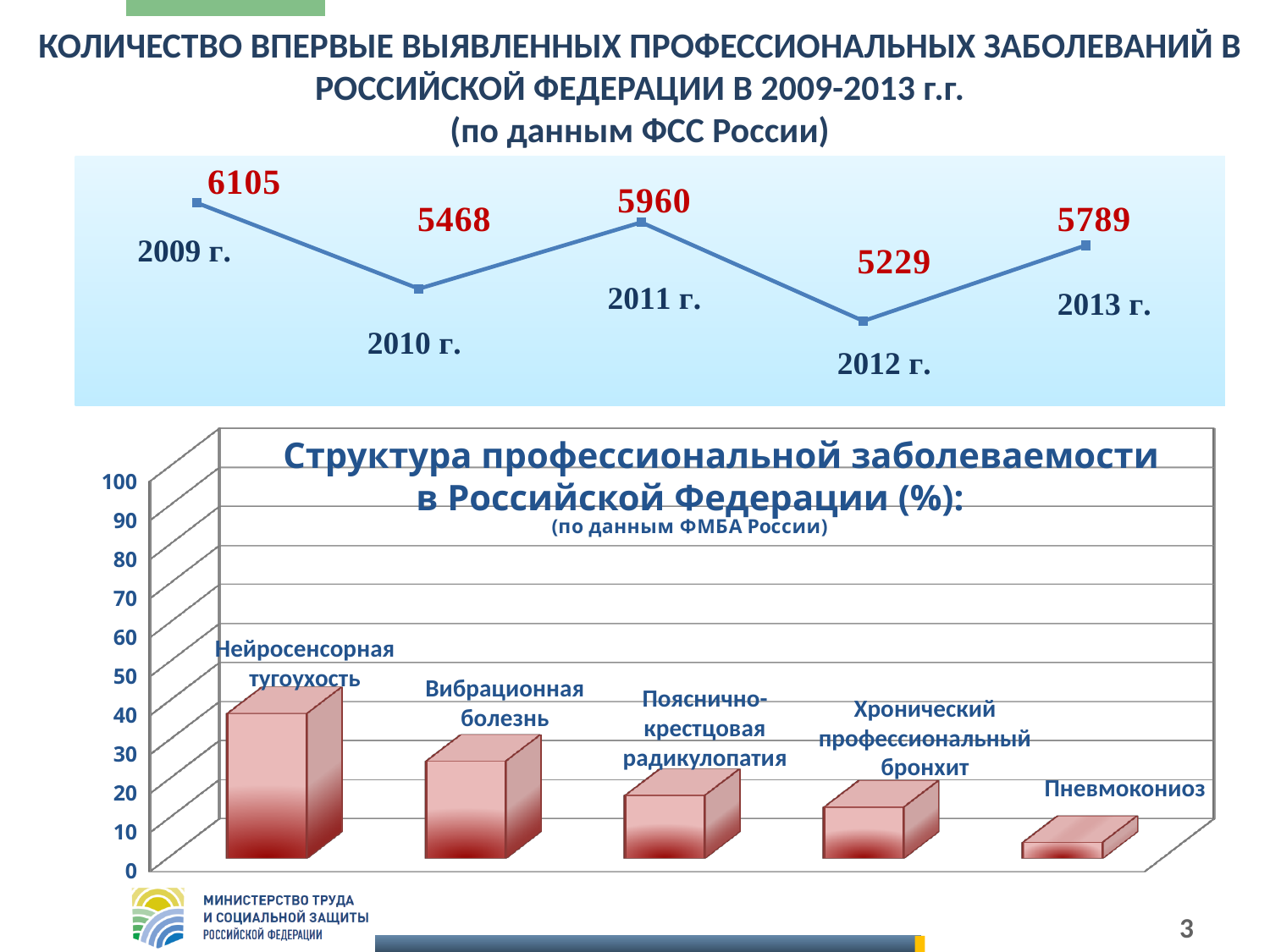
In the top chart, which year has the lowest value? 2012 г. In the bottom chart, is the value for Нейросенсорная тугоухость greater or less than 30? greater In the top chart, what is the value for 2012 г.? 5229 In the bottom chart (Структура профессиональной заболеваемости), which category has the highest value? Нейросенсорная тугоухость In the top chart (number of newly identified occupational diseases), what is the value for 2009 г.? 6105 In the top chart, which is larger: the value for 2013 г. or the value for 2012 г.? 2013 г. What kind of chart is the top chart? line chart In the top chart, how many years are plotted? 5 In the top chart, which year has the highest value? 2009 г. In the top chart, what is the difference between the values for 2011 г. and 2010 г.? 492 In the bottom chart, which category has the lowest value? Пневмокониоз In the bottom chart, is the value for Пневмокониоз greater or less than 10? less